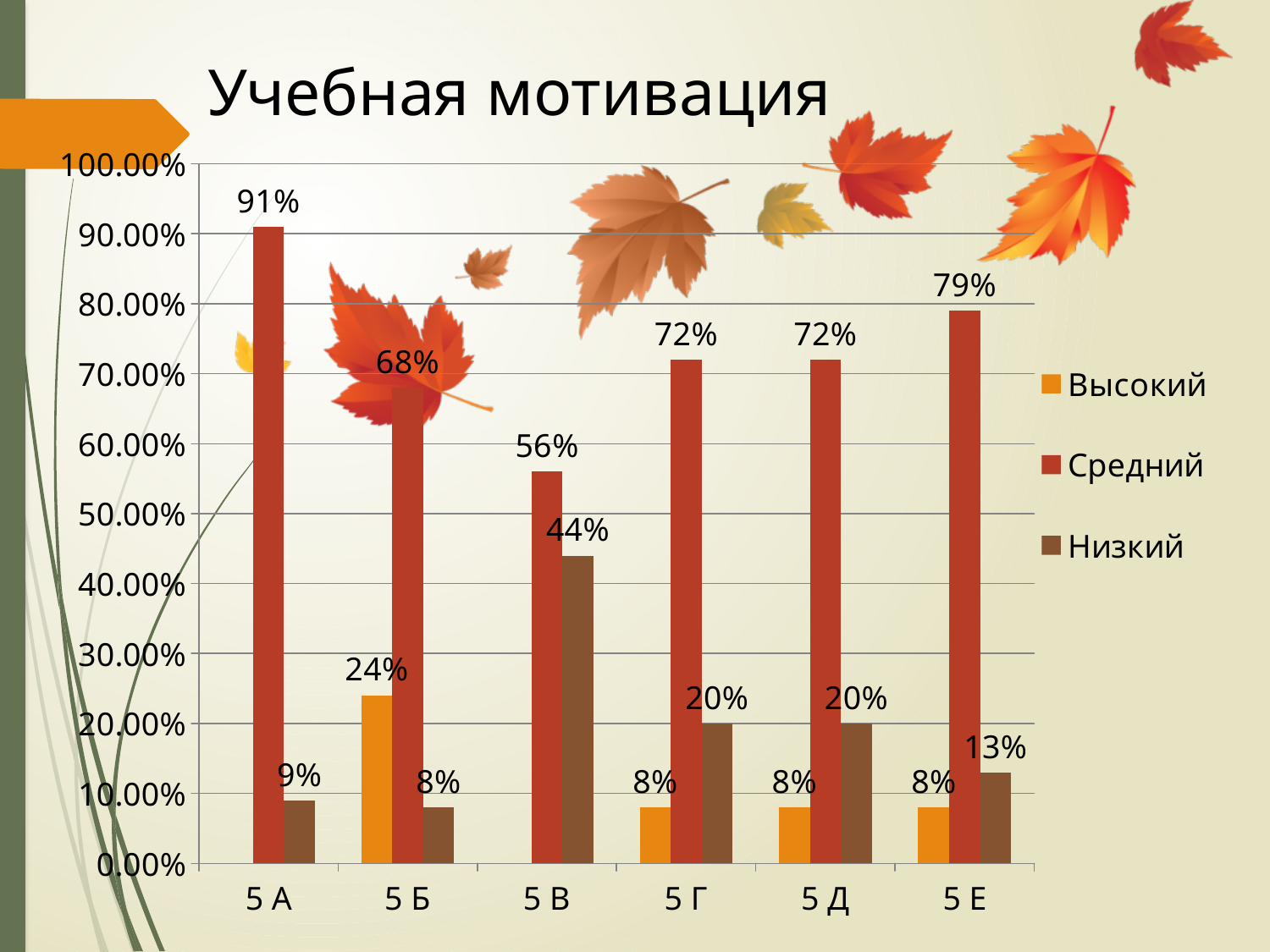
What type of chart is shown on the slide? bar chart What is the value of Средний for 5 Е? 79% What is the difference between the Средний values for 5 А and 5 Б? 23% How many series does the legend list? 3 What is the value of Высокий for 5 Б? 24% What is the value of Низкий for 5 В? 44% How many categories are shown on the x axis? 6 What is the value of Средний for 5 А? 91% Which is larger, the Низкий value for 5 Г or the Низкий value for 5 Е? 5 Г Is the Средний value for 5 В greater or less than 60.00%? less Which category has the lowest Средний value? 5 В Which category has the highest Средний value? 5 А